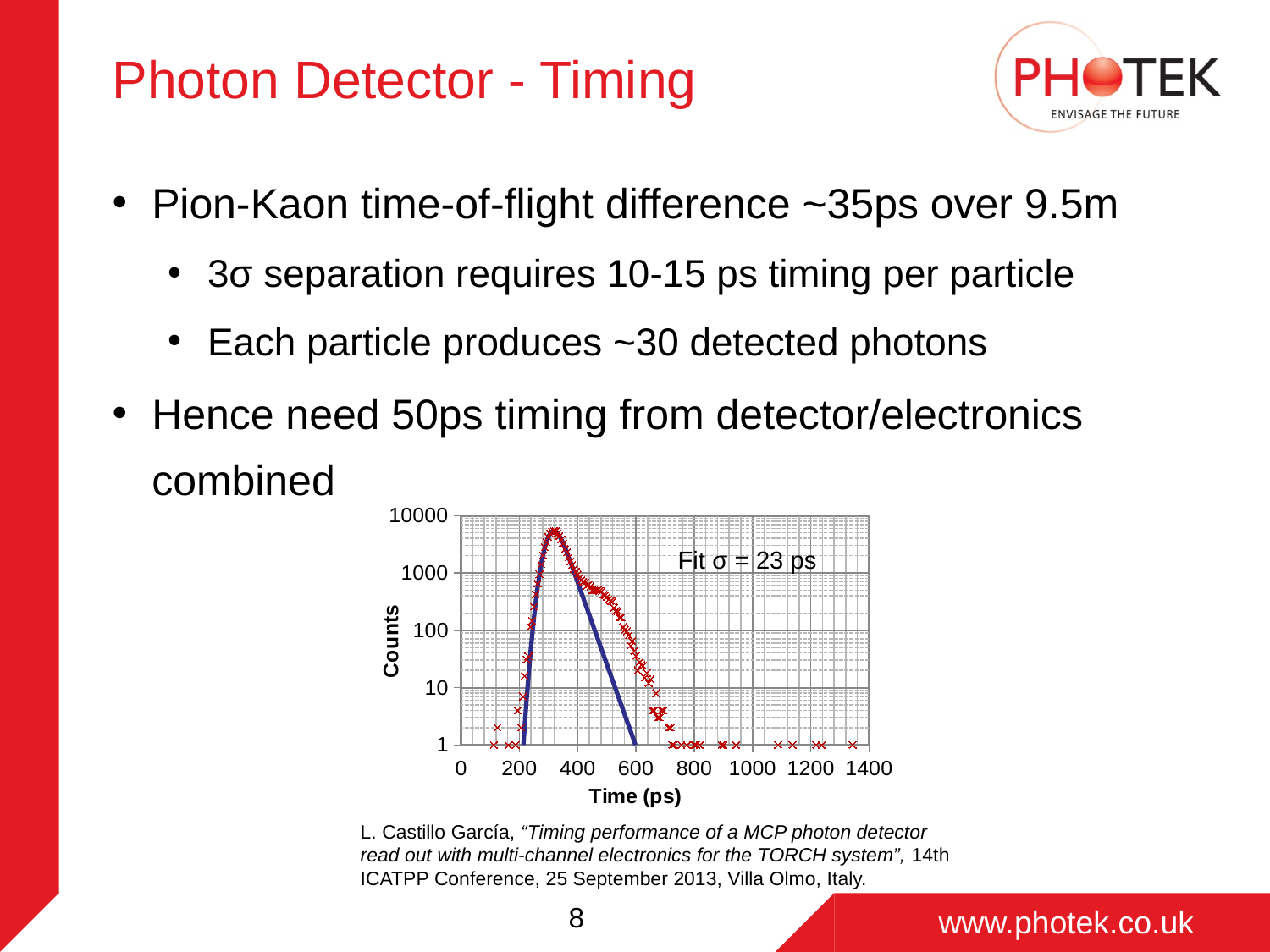
Is the value of Counts at around 800 ps greater or less than 10? less After the peak, do the Counts rise or fall as Time increases? fall What kind of chart is shown on the slide? scatter chart What is the title of the x axis of the chart? Time (ps) Is the value of Counts at around 1000 ps greater or less than 10? less Is the peak value of Counts greater or less than 1000? greater Are the Counts larger at around 300 ps or at around 600 ps? 300 ps What fit sigma value is printed on the chart? 23 ps What is the title of the y axis of the chart? Counts